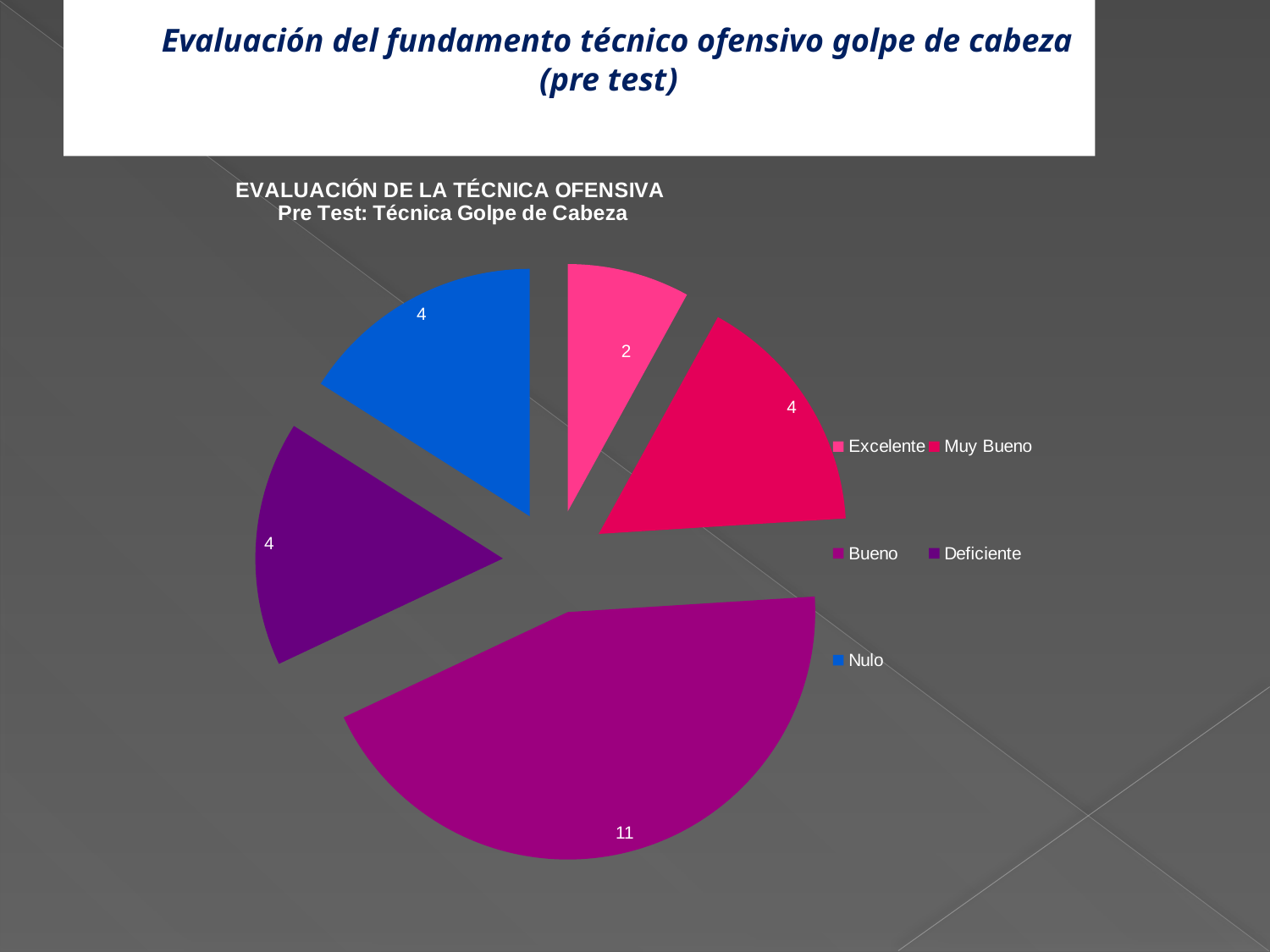
Which category has the smallest slice? Excelente What is the difference between the values for Bueno and Excelente? 9 What is the value for Nulo? 4 What is the value for Bueno? 11 Which category has the largest slice? Bueno What kind of chart is shown on the slide? pie chart What share of the total does the Bueno slice represent? 44% What share of the total does the Excelente slice represent? 8% Which is larger, the value for Muy Bueno or the value for Excelente? Muy Bueno How many slices does the pie chart have? 5 What is the subtitle of the chart below its main title? Pre Test: Técnica Golpe de Cabeza What is the value for Excelente? 2